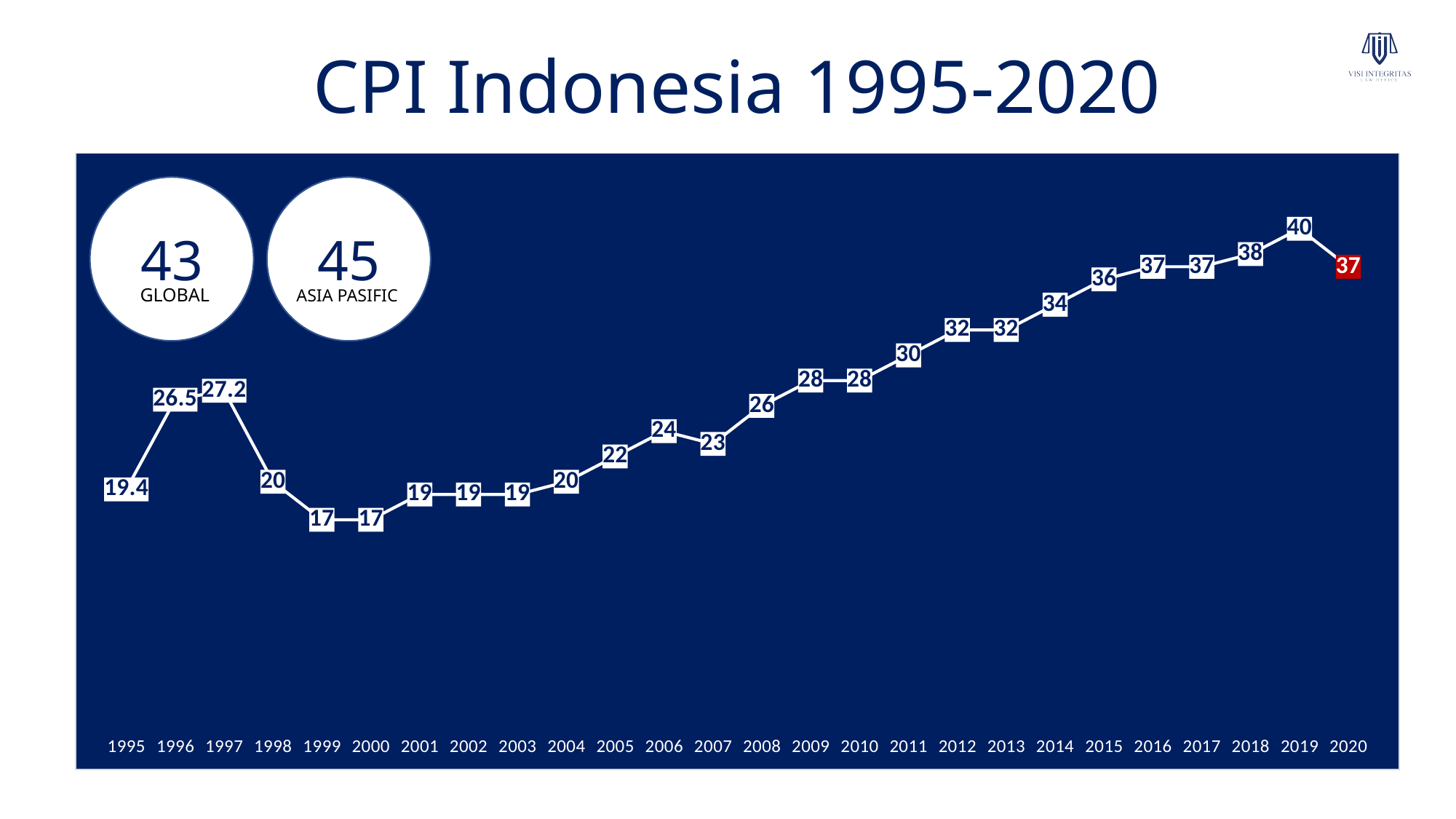
How many years (data points) are plotted on the chart? 26 What is the lowest CPI value shown on the chart? 17 What is the CPI value for Indonesia in 1997? 27.2 What is the CPI value for Indonesia in 2020? 37 Which year has the highest CPI value on the chart? 2019 What is the CPI value for Indonesia in 1995? 19.4 What kind of chart is shown on the slide? Line chart What is the overall trend of the CPI values from 2000 to 2019? Rising What is the difference between the CPI values for 1997 and 1995? 7.8 What is the CPI value for Indonesia in 2019? 40 What is the difference between the CPI values for 2019 and 2020? 3 Which year has a higher CPI value, 2006 or 2007? 2006